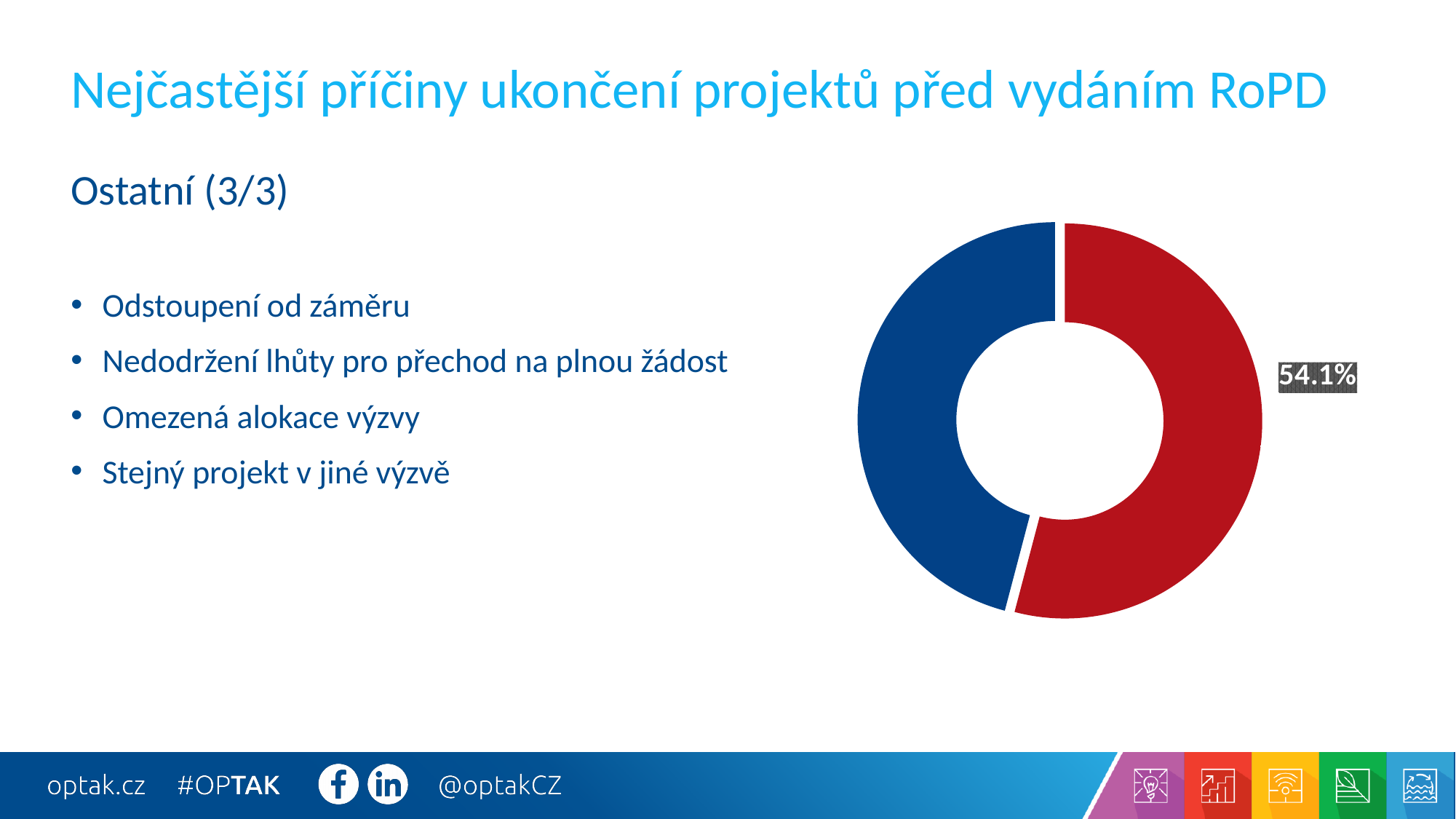
How many data labels are printed on the doughnut chart? 1 What kind of chart is shown on the slide? doughnut chart Is the share of the red slice greater or less than 50%? greater Is the share of the blue slice greater or less than 50%? less Which slice of the doughnut chart is the smallest? the blue slice Which slice of the doughnut chart is the largest? the red slice What value is printed on the red slice of the doughnut chart? 54.1% What share of the doughnut chart does the red slice represent? 54.1% What colour is the slice that carries the 54.1% label? red Which slice is larger, the red one or the blue one? the red one How many slices does the doughnut chart have? 2